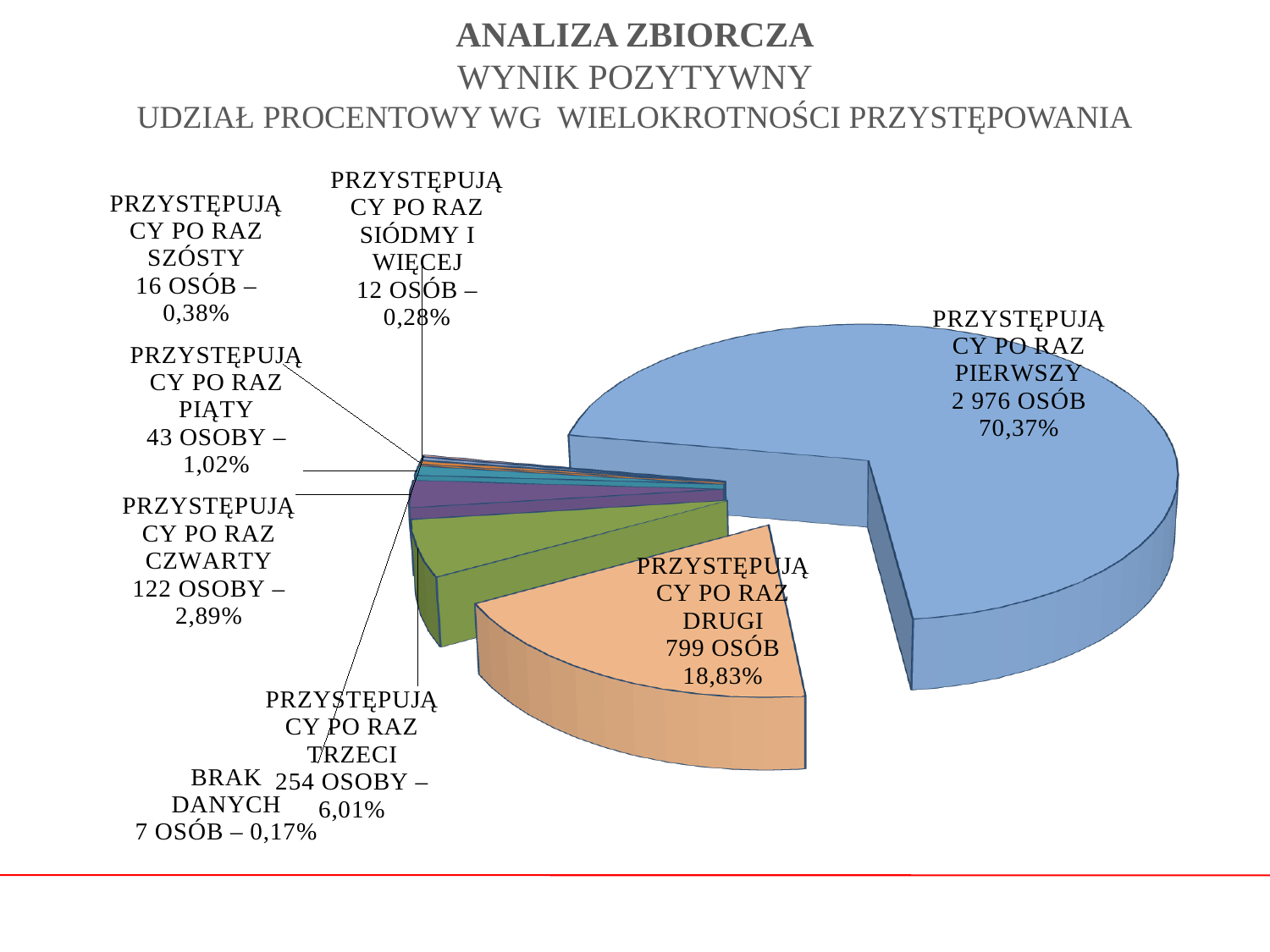
Which category has the smallest share of the pie? BRAK DANYCH What percentage share does the PRZYSTĘPUJĄCY PO RAZ CZWARTY slice have? 2,89% How many slices (categories) does the pie chart have? 8 What percentage share does the PRZYSTĘPUJĄCY PO RAZ DRUGI slice have? 18,83% Which category has the largest share of the pie? PRZYSTĘPUJĄCY PO RAZ PIERWSZY What percentage share does the BRAK DANYCH slice have? 0,17% What is the first line of the chart's title? ANALIZA ZBIORCZA How many people are in the PRZYSTĘPUJĄCY PO RAZ PIERWSZY category? 2 976 OSÓB How many people are in the PRZYSTĘPUJĄCY PO RAZ TRZECI category? 254 OSOBY Which category has more people: PRZYSTĘPUJĄCY PO RAZ PIĄTY or PRZYSTĘPUJĄCY PO RAZ SZÓSTY? PRZYSTĘPUJĄCY PO RAZ PIĄTY What is the difference in number of people between PRZYSTĘPUJĄCY PO RAZ PIERWSZY and PRZYSTĘPUJĄCY PO RAZ DRUGI? 2 177 What kind of chart is shown on the slide? Pie chart